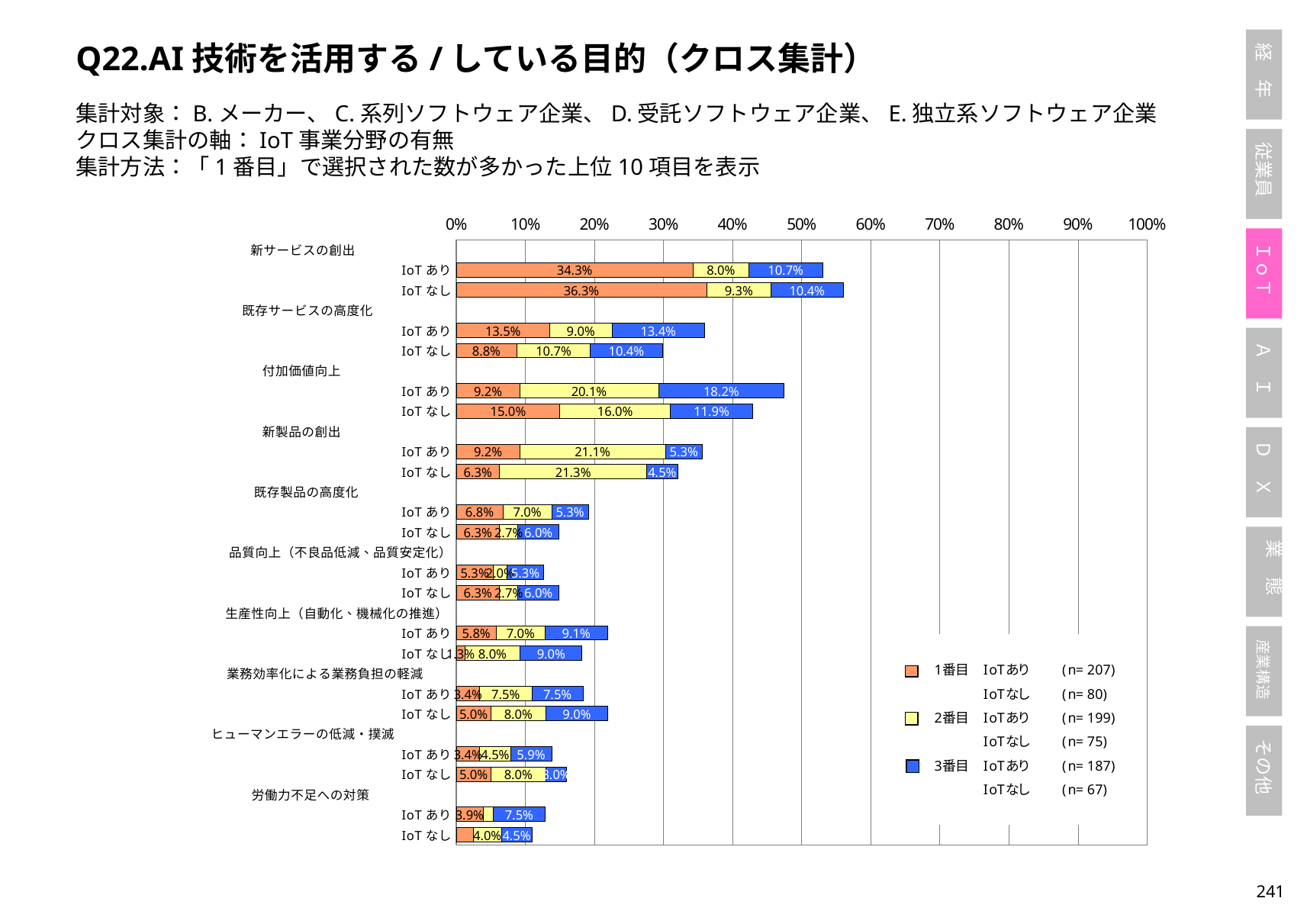
What is the 2番目 value for 付加価値向上 in the IoTあり row? 20.1% Which row has the highest 1番目 value on the chart? 新サービスの創出 IoTなし (36.3%) What is the sample size (n) shown in the legend for 1番目 IoTあり? 207 What is the difference between the 1番目 values for 新サービスの創出 in the IoTなし row and the IoTあり row? 2.0% What is the 3番目 value for 既存サービスの高度化 in the IoTあり row? 13.4% What kind of chart is shown on the slide? stacked bar chart Which is larger: the 2番目 value for 新製品の創出 in the IoTあり row or in the IoTなし row? IoTなし (21.3%) What is the 1番目 value for 新サービスの創出 in the IoTあり row? 34.3% Is the total of the stacked bar for 付加価値向上 in the IoTあり row greater or less than 40%? greater How many series does the legend list? 3 What is the total of the stacked bar for 新サービスの創出 in the IoTあり row? 53.0% How many purpose categories are shown on the chart? 10